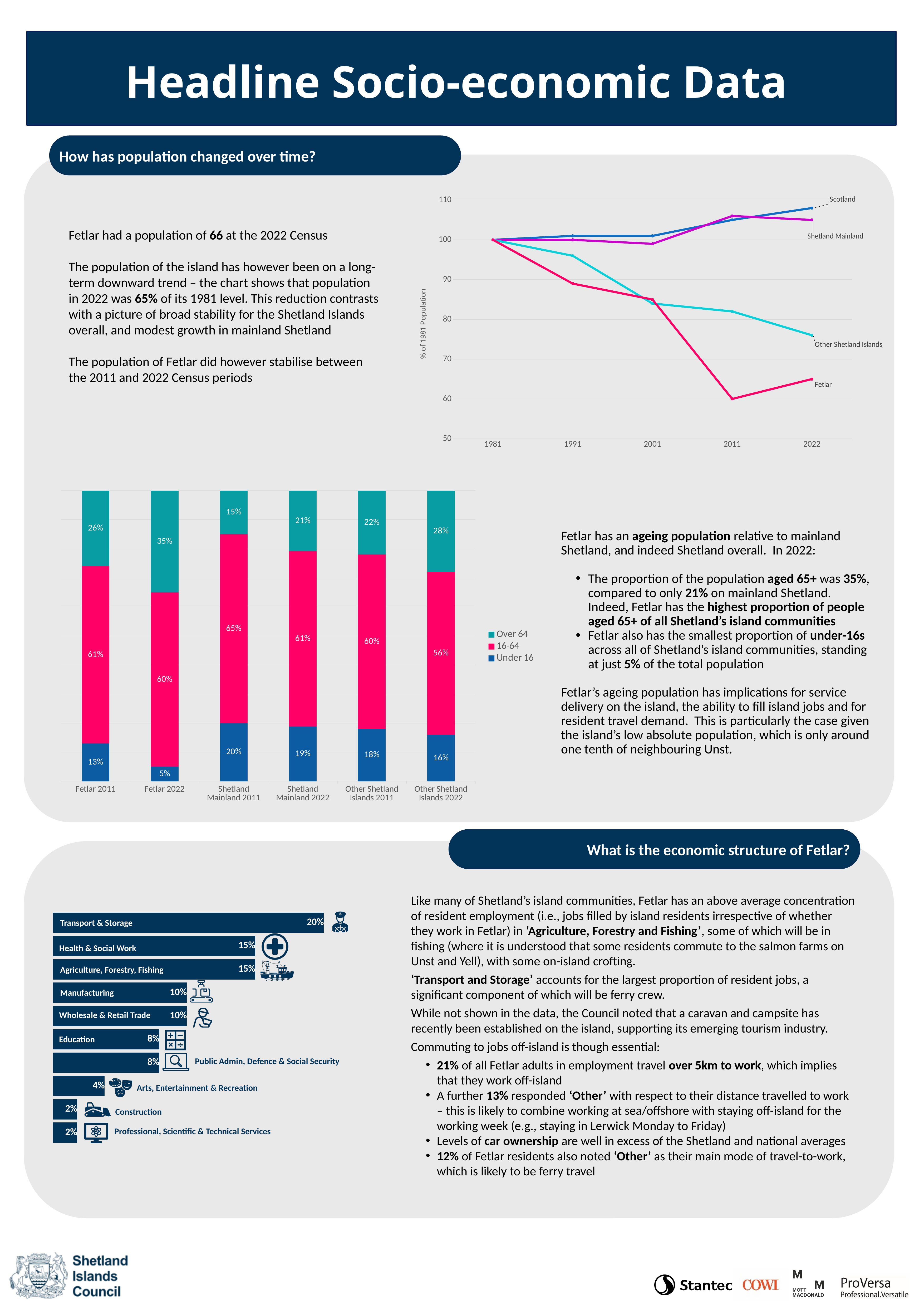
In the line chart of population as a percentage of 1981 levels, is the value for Scotland in 2022 greater or less than 100? greater In the stacked bar chart of age structure, what is the difference in percentage points between the Over 64 share for Fetlar 2022 and for Shetland Mainland 2022? 14 In the line chart of population as a percentage of 1981 levels, does the Other Shetland Islands line rise or fall from 1981 to 2022? fall In the line chart of population as a percentage of 1981 levels, what kind of chart is it? line chart In the line chart of population as a percentage of 1981 levels, which area has the lowest value in 2022? Fetlar In the line chart of population as a percentage of 1981 levels, is the value for Fetlar in 2011 greater or less than 70? less In the line chart of population as a percentage of 1981 levels, how many census years are shown on the x axis? 5 In the stacked bar chart of age structure, how many series does the legend list? 3 In the horizontal bar chart of economic structure, what is the value for Education? 8% In the stacked bar chart of age structure, what percentage of the Fetlar 2022 population is Over 64? 35% In the stacked bar chart of age structure, what percentage of the Shetland Mainland 2011 population is aged 16-64? 65% In the horizontal bar chart of economic structure, which sector has the highest share? Transport & Storage